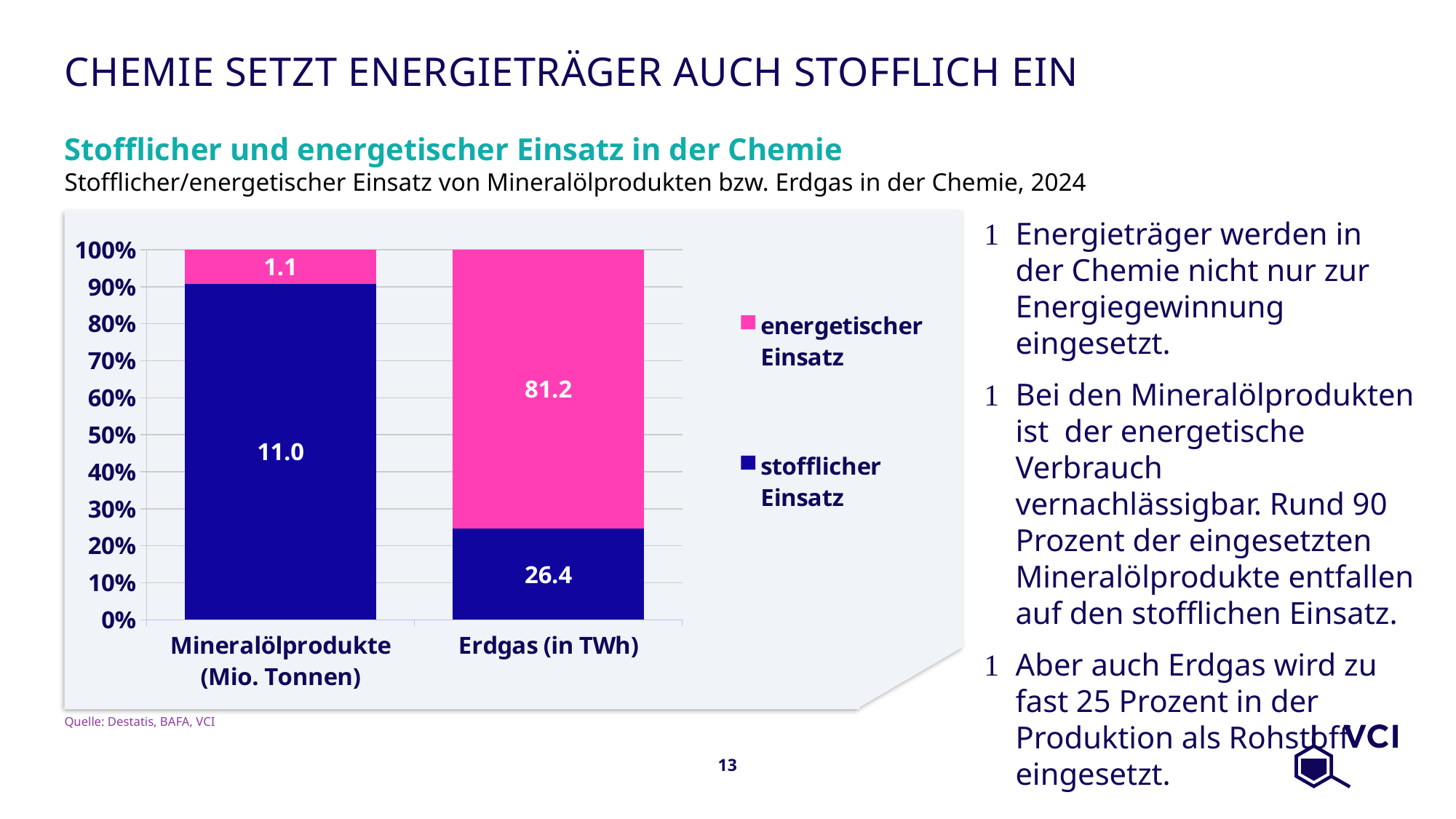
For Erdgas (in TWh), which is larger: energetischer Einsatz or stofflicher Einsatz? energetischer Einsatz How many series does the legend list? 2 What is the value of energetischer Einsatz for Erdgas (in TWh)? 81.2 Is the share of stofflicher Einsatz for Erdgas (in TWh) greater or less than 30%? less What is the value of stofflicher Einsatz for Erdgas (in TWh)? 26.4 What is the total of the two labelled values for Mineralölprodukte (Mio. Tonnen)? 12.1 How many categories are shown on the x axis? 2 What is the value of energetischer Einsatz for Mineralölprodukte (Mio. Tonnen)? 1.1 What is the value of stofflicher Einsatz for Mineralölprodukte (Mio. Tonnen)? 11.0 Which colour represents energetischer Einsatz in the chart? Pink What is the difference between energetischer Einsatz and stofflicher Einsatz for Erdgas (in TWh)? 54.8 What type of chart is shown on the slide? Stacked bar chart